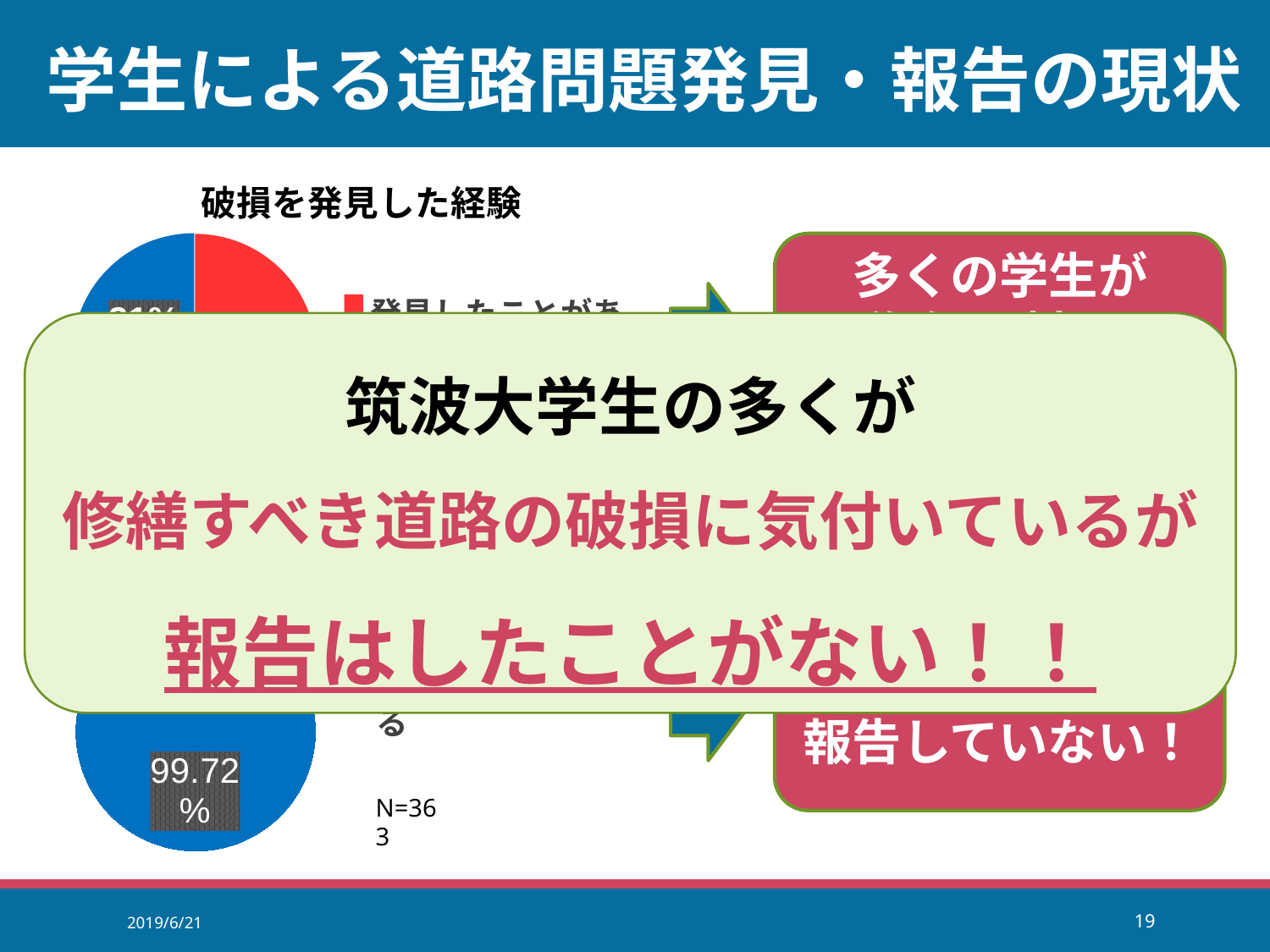
What is the title of the upper pie chart? 破損を発見した経験 What kind of chart is the lower chart on the left side of the slide? pie chart In the lower pie chart on the left, which colour slice is the largest? blue In the lower pie chart on the left, what share of the pie does the largest slice take? 99.72% In the lower pie chart on the left, is the blue slice larger or smaller than the other slice? larger What sample size (N) is printed next to the lower pie chart? N=363 In the lower pie chart on the left, what value is printed on the blue slice? 99.72% What kind of chart is the chart titled 破損を発見した経験? pie chart How many pie charts are shown on the slide? 2